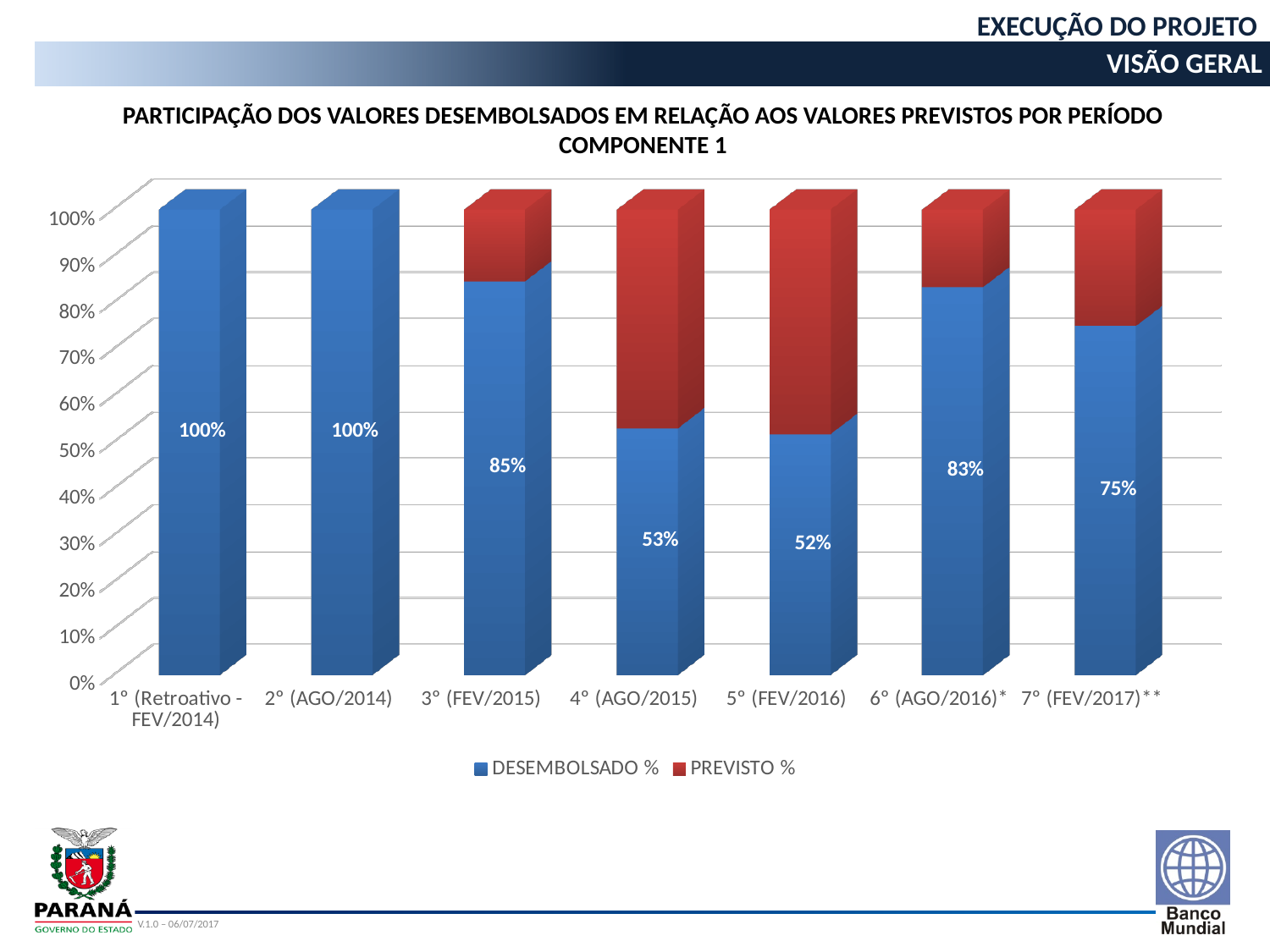
Is the DESEMBOLSADO % value for 5° (FEV/2016) greater or less than 60%? less How many periods are shown on the x axis of the chart? 7 What is the DESEMBOLSADO % value for 4° (AGO/2015)? 53% Which has a larger DESEMBOLSADO % value, 6° (AGO/2016)* or 7° (FEV/2017)**? 6° (AGO/2016)* Which period has the lowest DESEMBOLSADO % value? 5° (FEV/2016) What is the difference between the DESEMBOLSADO % values for 3° (FEV/2015) and 4° (AGO/2015)? 32% What is the DESEMBOLSADO % value for 3° (FEV/2015)? 85% How many series does the chart legend list? 2 What kind of chart is shown on the slide? Stacked bar chart Which series is shown in red in the chart? PREVISTO % What is the DESEMBOLSADO % value for 6° (AGO/2016)*? 83% What is the DESEMBOLSADO % value for 7° (FEV/2017)**? 75%